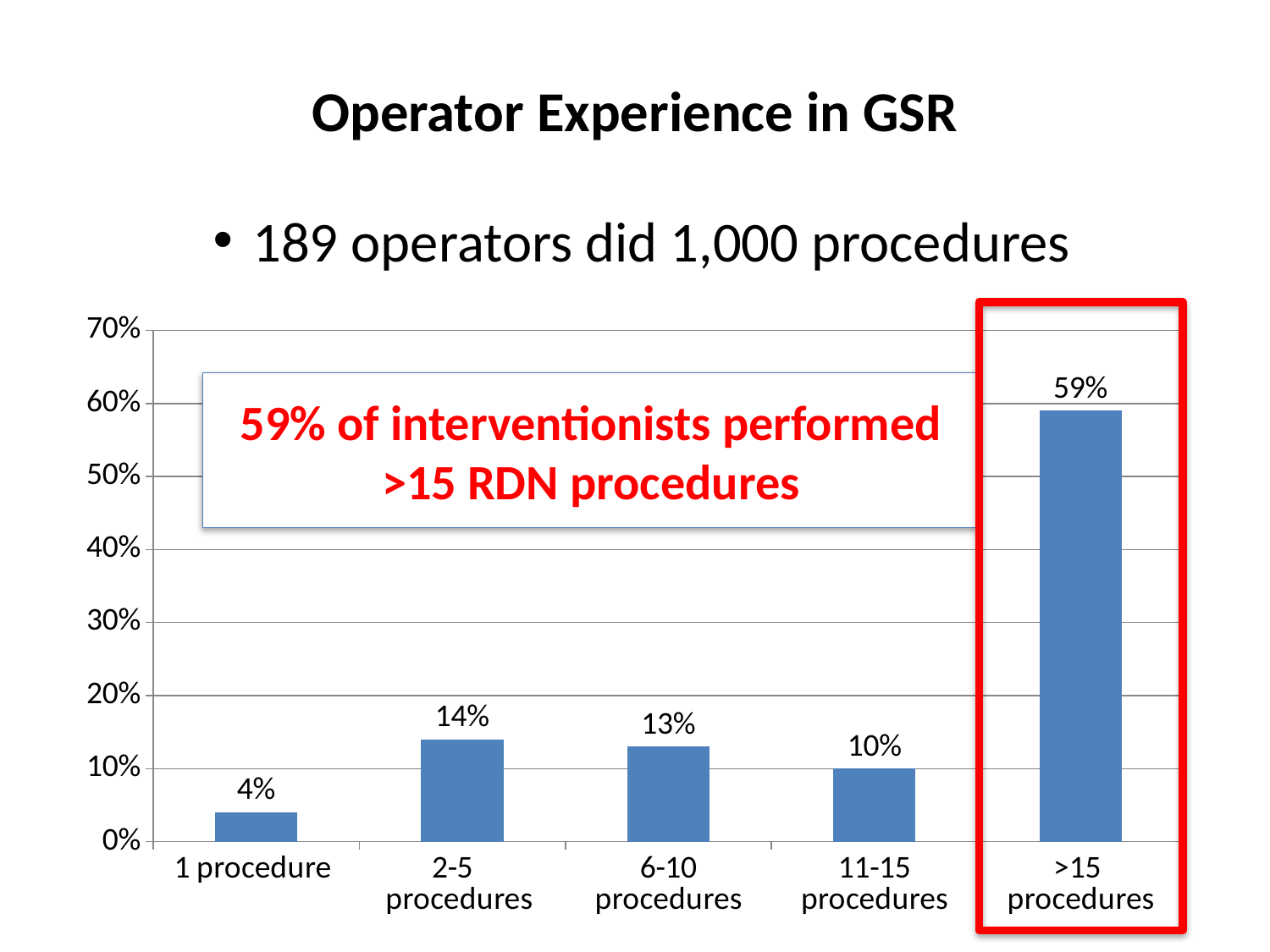
What percentage of operators performed 1 procedure? 4% What percentage of operators performed 6-10 procedures? 13% What kind of chart is shown on the slide? Bar chart Which category has the highest percentage of operators? >15 procedures Which category has the lowest percentage of operators? 1 procedure Which is larger, the value for 2-5 procedures or the value for 11-15 procedures? 2-5 procedures What percentage of operators performed 11-15 procedures? 10% What is the difference between the percentage for >15 procedures and the percentage for 11-15 procedures? 49% What percentage of operators performed >15 procedures? 59% What percentage of operators performed 2-5 procedures? 14% What is the title of the slide containing the chart? Operator Experience in GSR How many categories are shown on the x axis of the chart? 5